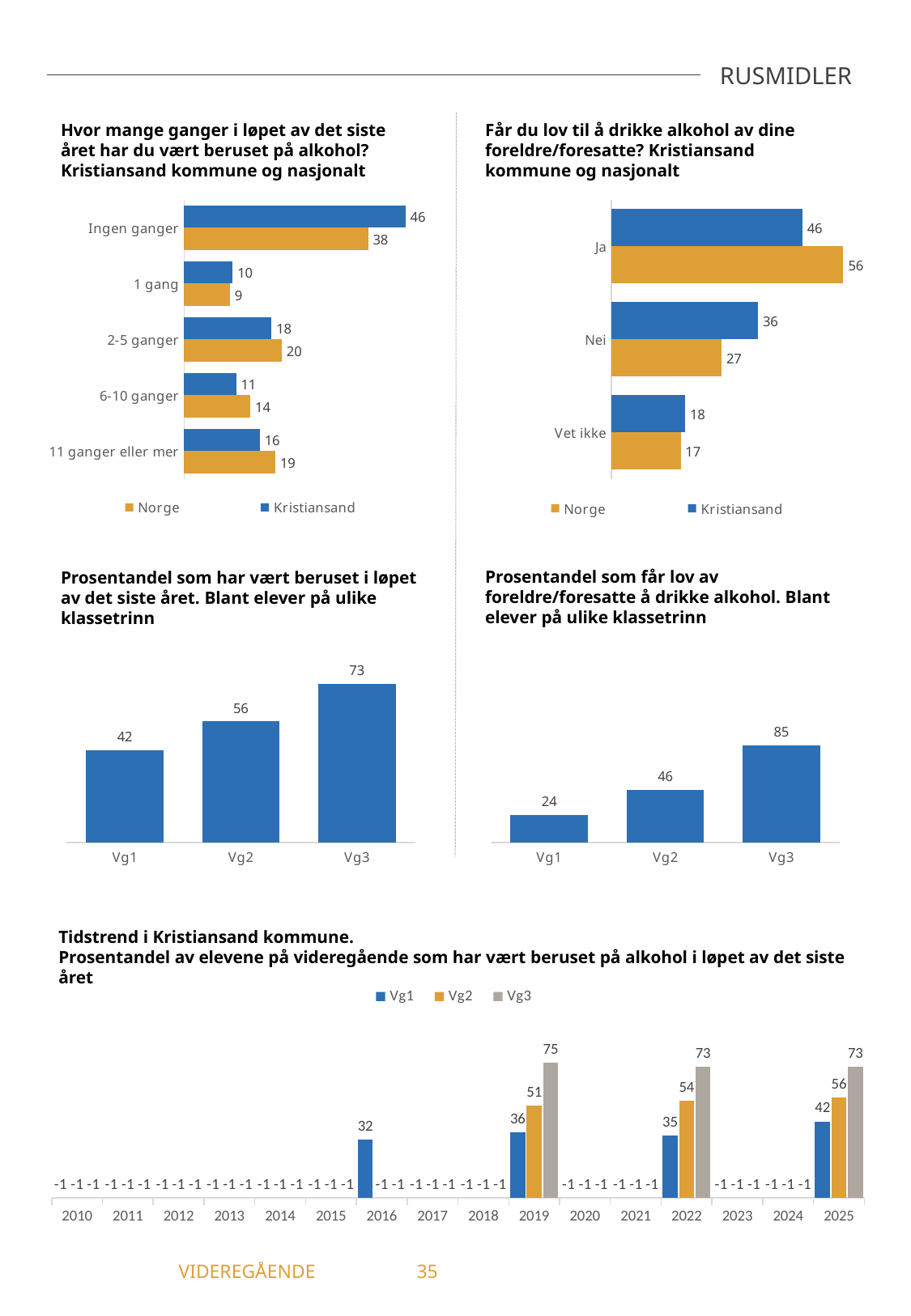
In the top-right chart (Får du lov til å drikke alkohol ...), what is the value for Norge for 'Ja'? 56 In the top-left chart (Hvor mange ganger ... beruset på alkohol), how many categories are shown? 5 In the top-right chart (Får du lov til å drikke alkohol ...), how many series does the legend list? 2 In the top-left chart (Hvor mange ganger ... beruset på alkohol), what is the value for Kristiansand for 'Ingen ganger'? 46 In the middle-right chart (Prosentandel som får lov av foreldre ...), what is the difference between Vg3 and Vg1? 61 In the top-left chart (Hvor mange ganger ... beruset på alkohol), what is the difference between the Norge and Kristiansand values for '2-5 ganger'? 2 What kind of chart is the bottom chart (Tidstrend i Kristiansand kommune)? bar chart In the top-right chart (Får du lov til å drikke alkohol ...), which is larger for 'Nei': Kristiansand or Norge? Kristiansand In the bottom chart (Tidstrend i Kristiansand kommune), what is the value for Vg2 in 2022? 54 In the middle-left chart (Prosentandel som har vært beruset ...), which class level has the highest value? Vg3 In the middle-left chart (Prosentandel som har vært beruset ...), what is the value for Vg2? 56 In the middle-right chart (Prosentandel som får lov av foreldre ...), do the values rise or fall from Vg1 to Vg3? rise